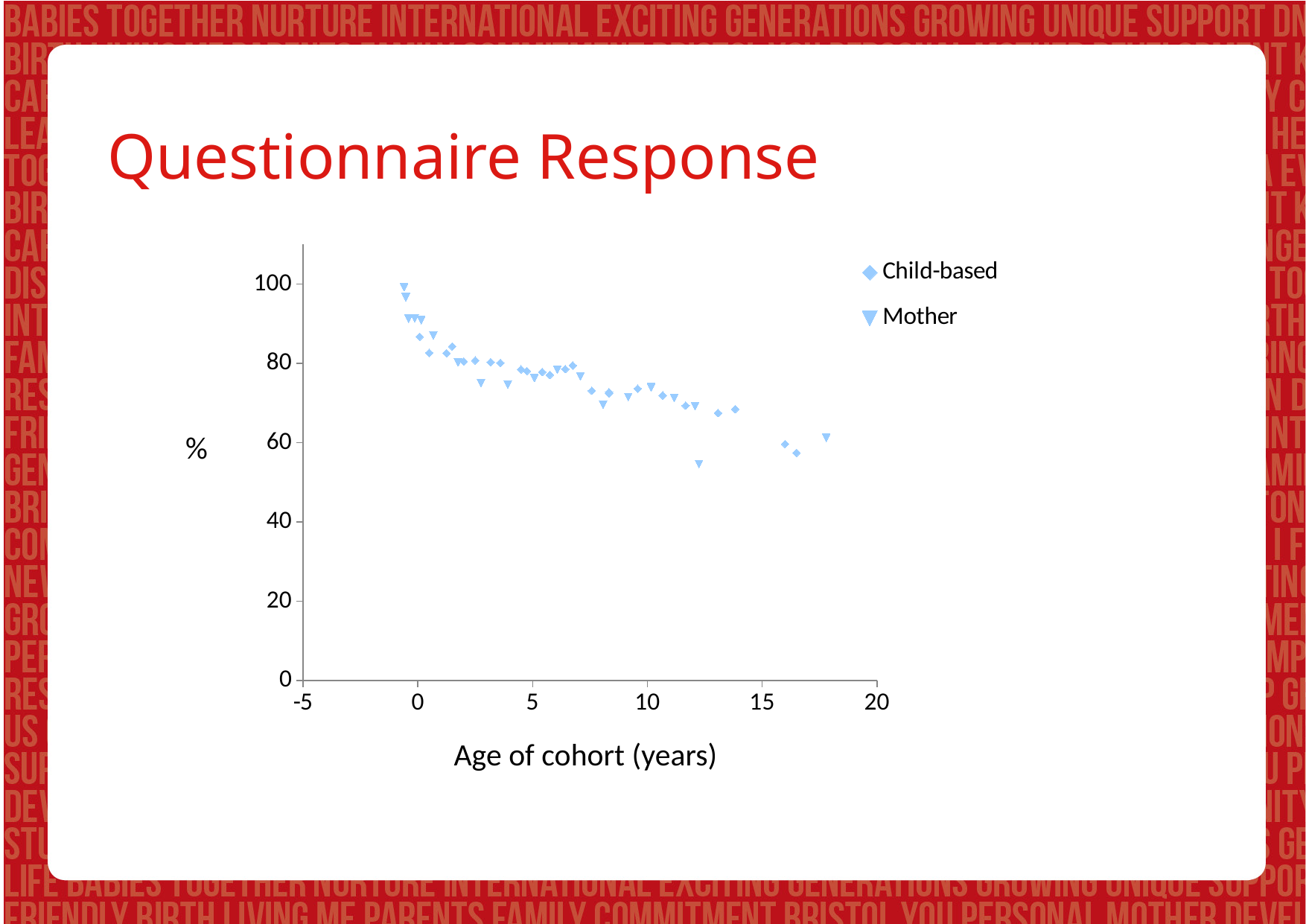
How many series does the legend list? 2 Do the plotted values generally rise or fall as the age of cohort increases? Fall Which series contains the lowest plotted point on the chart? Mother What kind of chart is shown on the slide? Scatter chart Is the highest plotted value greater or less than 80? greater What is the label of the x axis? Age of cohort (years) Is the lowest plotted value greater or less than 60? less What are the two series named in the legend? Child-based and Mother Is the Child-based value plotted at about age 16 greater or less than 80? less